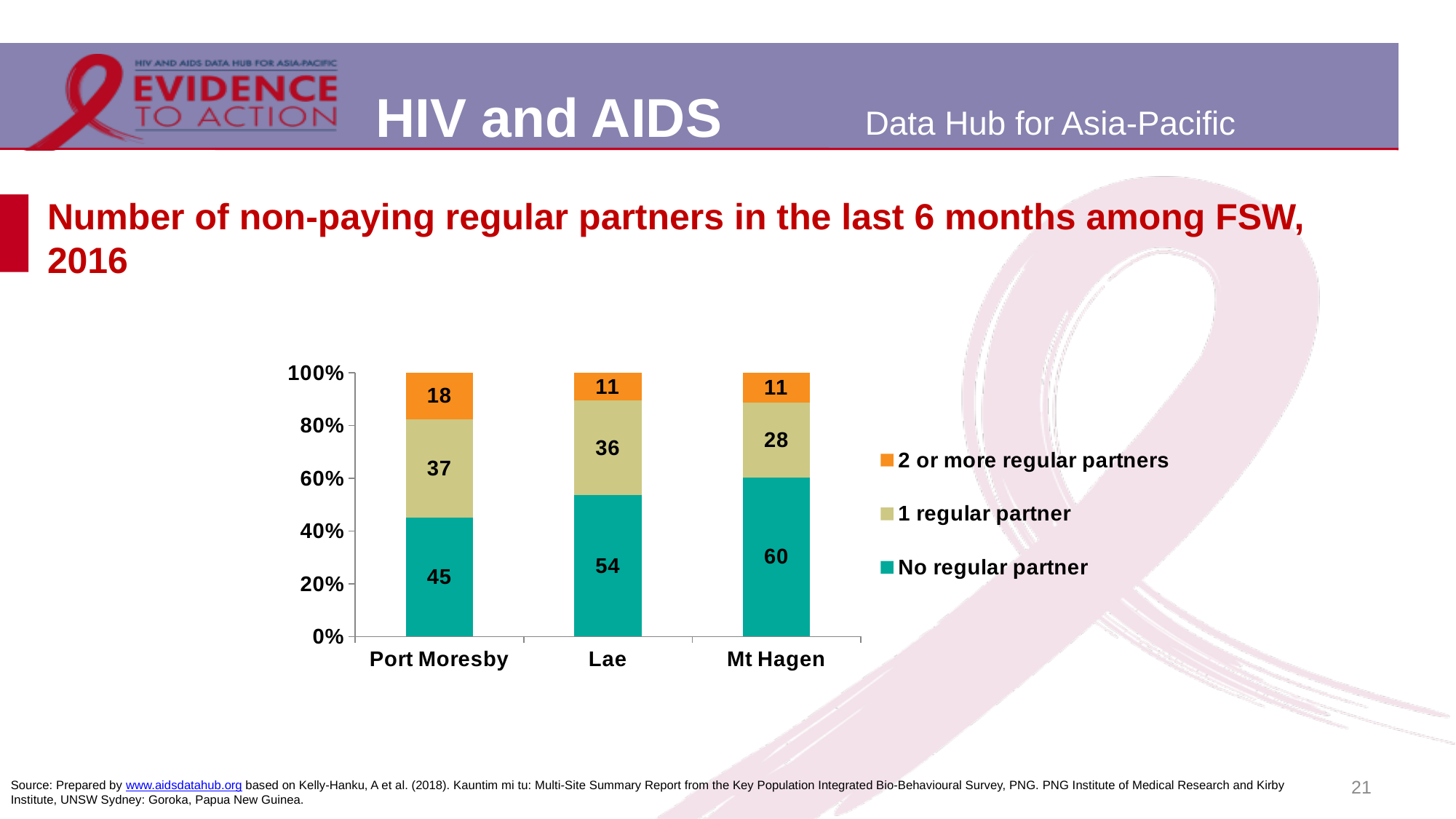
Which is larger: the '2 or more regular partners' value for Port Moresby or for Lae? Port Moresby What kind of chart is shown on the slide? Stacked bar chart How many cities are shown on the x axis? 3 What is the value for 'No regular partner' in Port Moresby? 45 What is the difference between the 'No regular partner' values for Mt Hagen and Port Moresby? 15 Which colour represents '2 or more regular partners' in the chart? Orange How many series does the legend list? 3 What is the value for '1 regular partner' in Lae? 36 What is the value for '2 or more regular partners' in Mt Hagen? 11 Does the 'No regular partner' value rise or fall from Port Moresby to Mt Hagen? Rise Which city has the highest value for 'No regular partner'? Mt Hagen Which city has the lowest value for '1 regular partner'? Mt Hagen